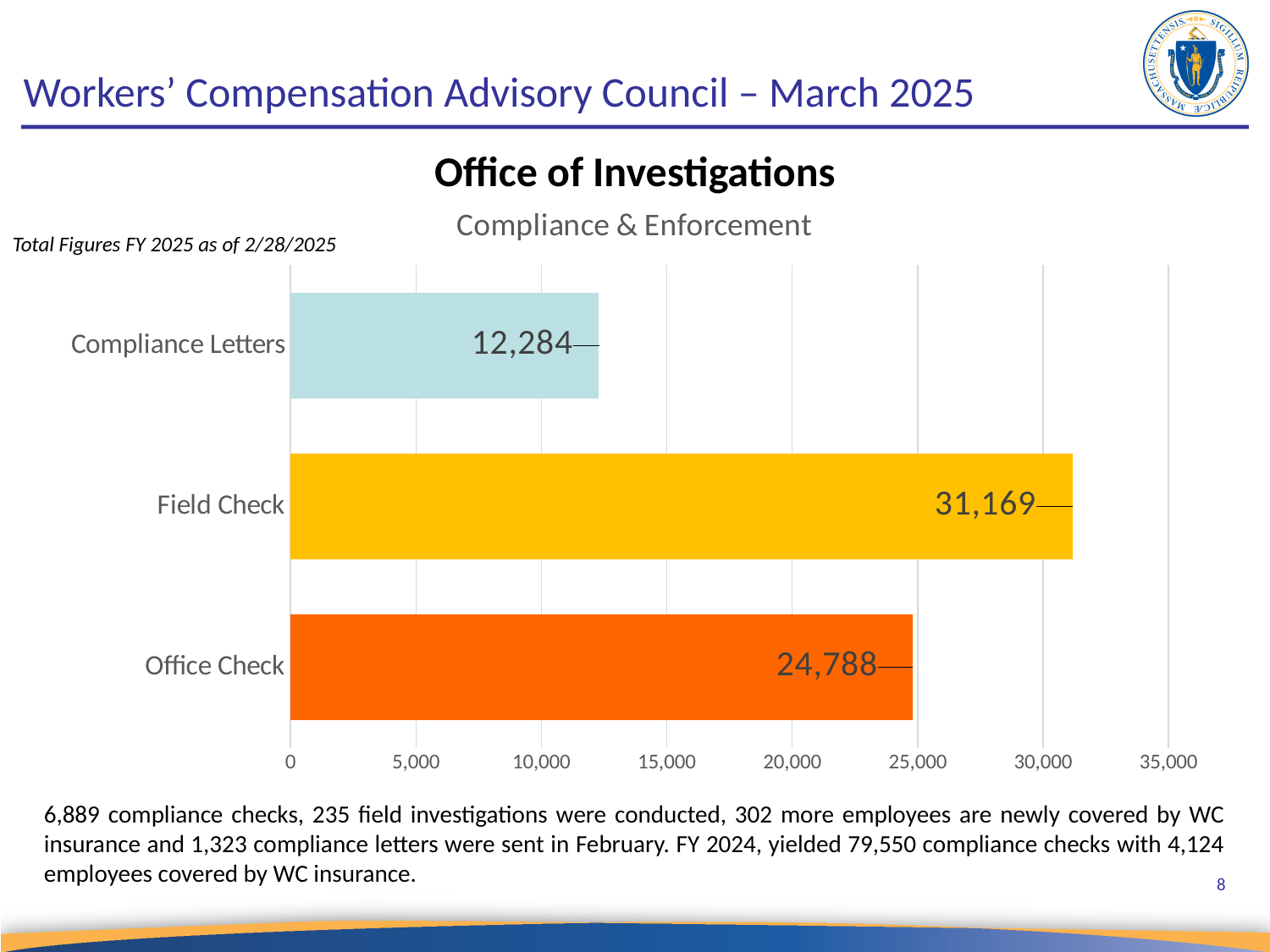
How many categories are shown in the chart? 3 Which is larger, Office Check or Compliance Letters? Office Check What is the difference between the Office Check and Compliance Letters values? 12,504 What is the value for Field Check? 31,169 Which category has the highest value? Field Check Is the value for Field Check greater or less than 30,000? greater What kind of chart is shown? bar chart Which category has the lowest value? Compliance Letters What is the difference between the Field Check and Office Check values? 6,381 What is the value for Office Check? 24,788 What is the title of the chart? Compliance & Enforcement What is the value for Compliance Letters? 12,284